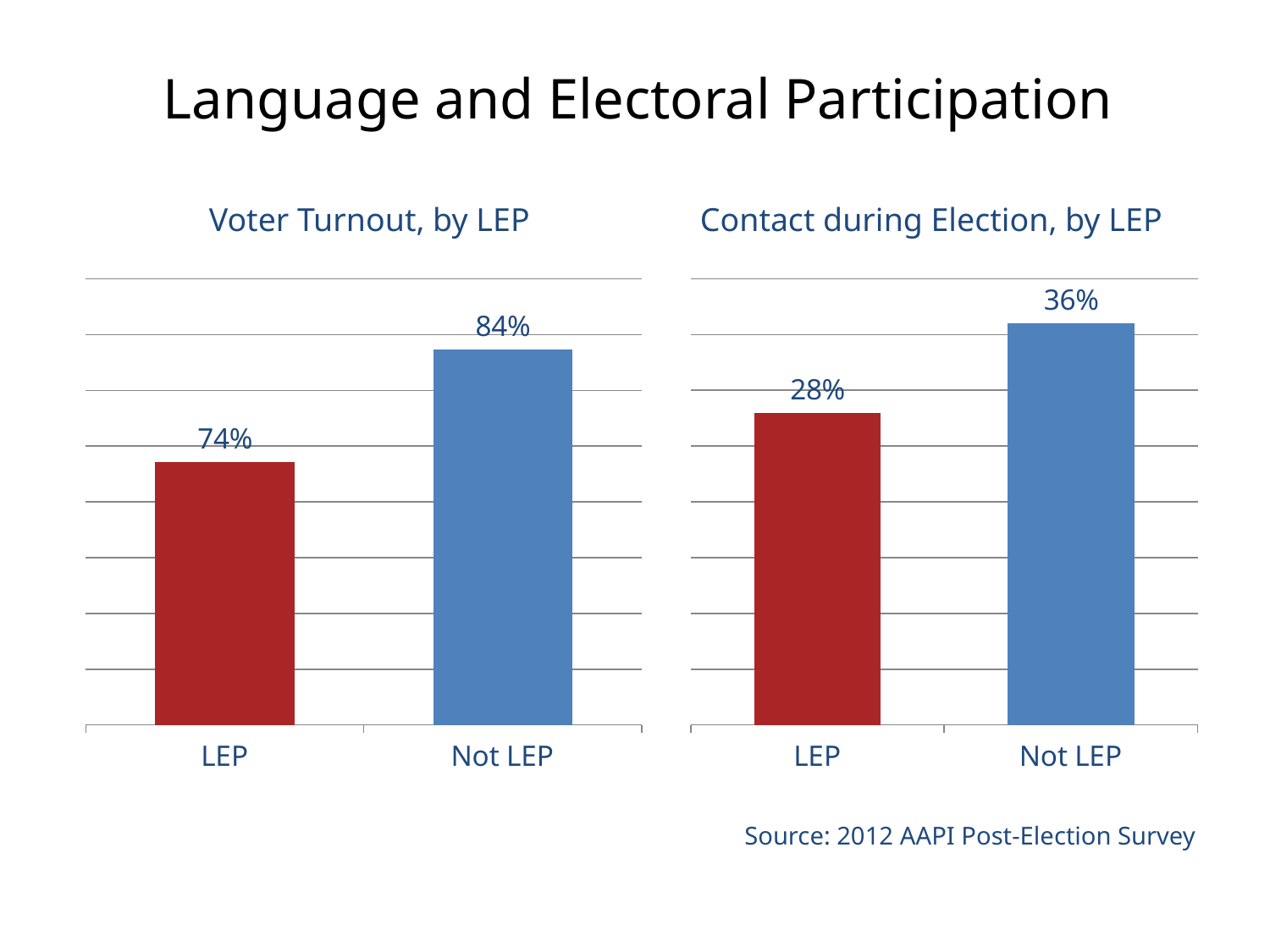
In the 'Contact during Election, by LEP' chart, is the value for LEP larger or smaller than the value for Not LEP? smaller In the 'Voter Turnout, by LEP' chart, what is the value for Not LEP? 84% In the 'Contact during Election, by LEP' chart, what is the difference between the Not LEP and LEP values? 8% In the 'Contact during Election, by LEP' chart, what is the value for Not LEP? 36% How many categories are shown in the 'Voter Turnout, by LEP' chart? 2 In the 'Contact during Election, by LEP' chart, what is the value for LEP? 28% In the 'Voter Turnout, by LEP' chart, what is the value for LEP? 74% What kind of chart is the 'Contact during Election, by LEP' chart? bar chart In the 'Contact during Election, by LEP' chart, which category has the lower value? LEP In the 'Voter Turnout, by LEP' chart, which category has the higher value? Not LEP In the 'Voter Turnout, by LEP' chart, what is the difference between the Not LEP and LEP values? 10% What is the title of the chart on the left side of the slide? Voter Turnout, by LEP